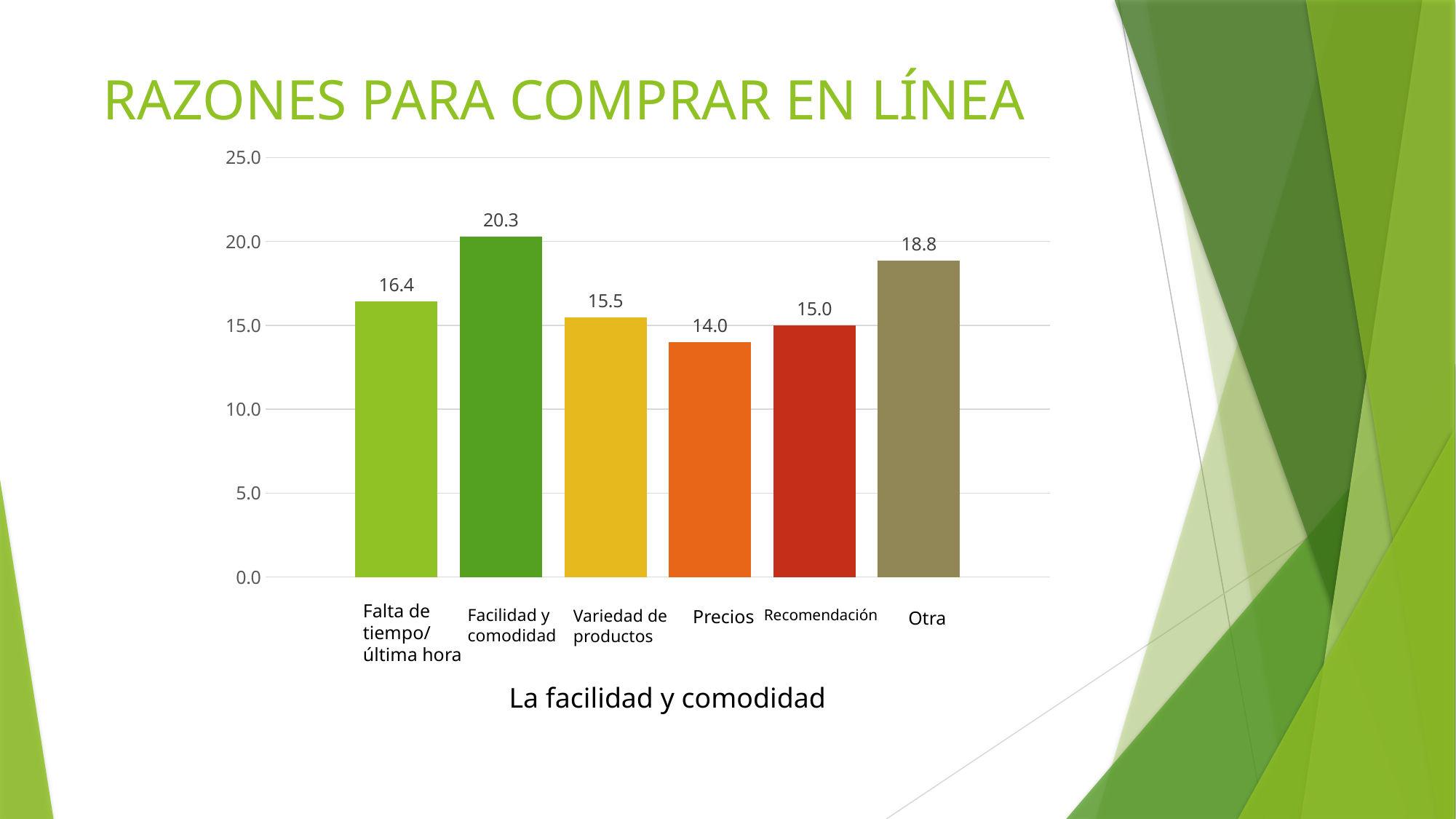
Which category has the lowest value? Precios What is the difference between the values for Facilidad y comodidad and Precios? 6.3 What is the value for Falta de tiempo/última hora? 16.4 Which category has the highest value? Facilidad y comodidad Which is larger, the value for Variedad de productos or the value for Otra? Otra What is the difference between the values for Otra and Recomendación? 3.8 What kind of chart is shown on the slide? Bar chart How many categories are shown in the chart? 6 What is the value for Facilidad y comodidad? 20.3 What is the value for Precios? 14.0 What is the value for Otra? 18.8 What is the title of the slide? RAZONES PARA COMPRAR EN LÍNEA